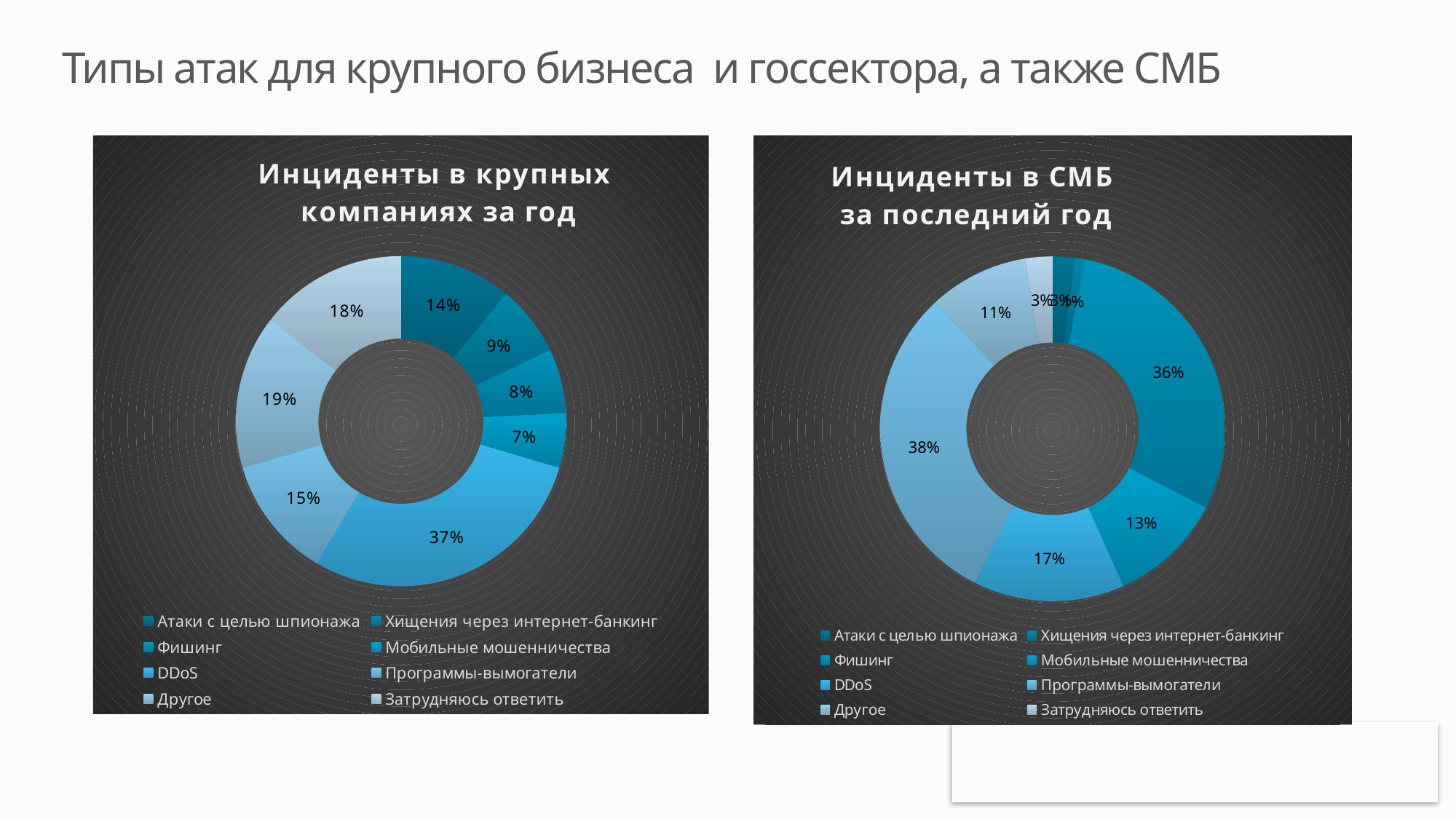
How many slices does the chart "Инциденты в крупных компаниях за год" have? 8 In the chart "Инциденты в крупных компаниях за год", which category has the smallest share? Мобильные мошенничества (7%) In the chart "Инциденты в СМБ за последний год", what is the largest value shown? 38% In the chart "Инциденты в крупных компаниях за год", what is the difference between the shares for Другое and Затрудняюсь ответить? 1 percentage point (19% vs 18%) In the chart "Инциденты в крупных компаниях за год", which is larger: the share for DDoS or for Программы-вымогатели? DDoS (37% vs 15%) In the chart "Инциденты в СМБ за последний год", what is the difference between the two largest slices (38% and 36%)? 2 percentage points In the chart "Инциденты в СМБ за последний год", what is the smallest value shown? 1% In the chart "Инциденты в крупных компаниях за год", what is the value for Атаки с целью шпионажа? 14% What kind of chart is "Инциденты в крупных компаниях за год"? A doughnut (pie) chart In the chart "Инциденты в крупных компаниях за год", what is the value for DDoS? 37% How many entries does the legend of the chart "Инциденты в СМБ за последний год" list? 8 In the chart "Инциденты в крупных компаниях за год", which category has the largest share? DDoS (37%)